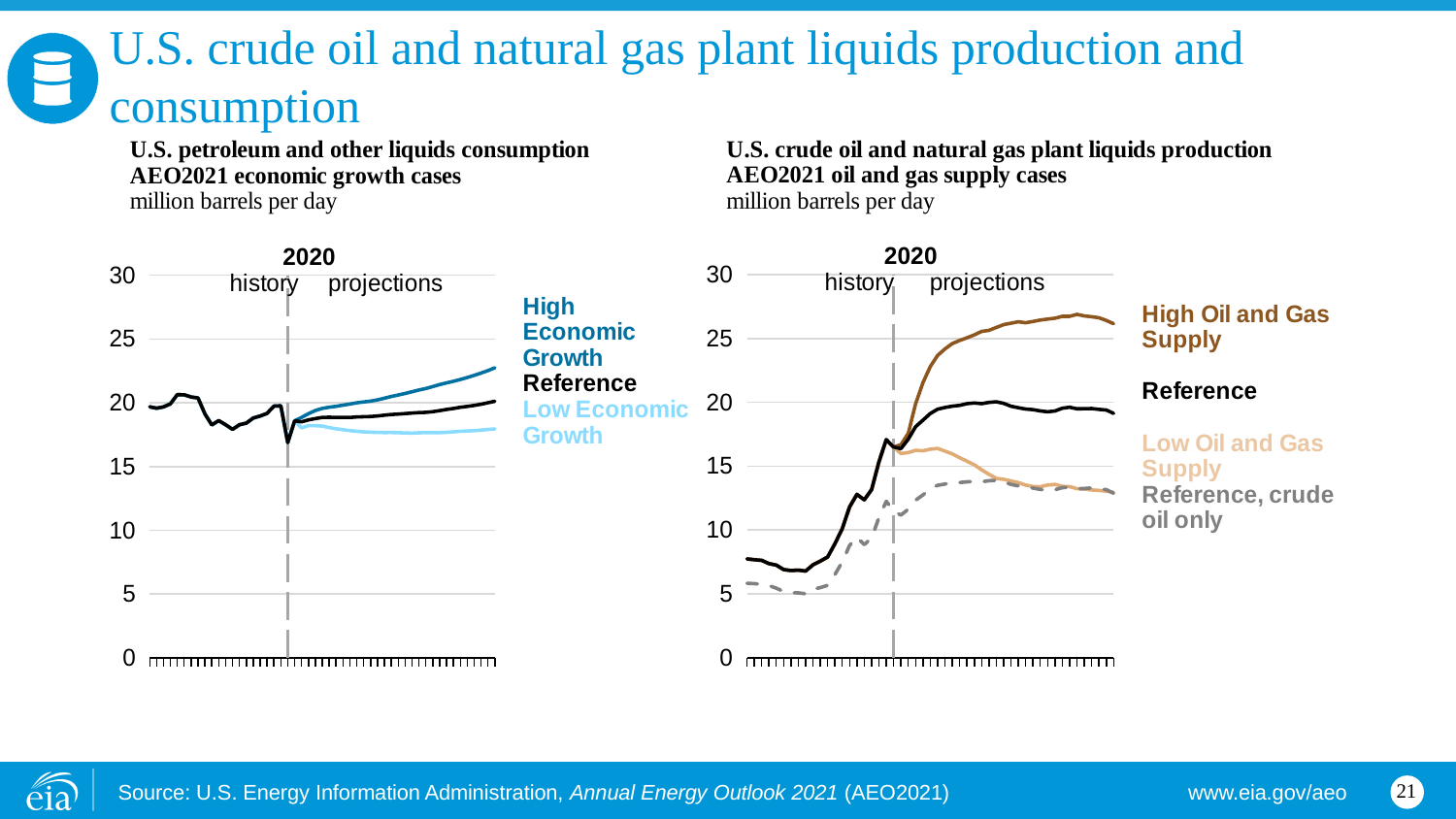
On the left chart, does the High Economic Growth series rise or fall over the projection period? rise How many series are labelled on the right chart, U.S. crude oil and natural gas plant liquids production? 4 On the right chart, which series is highest at the end of the projection period? High Oil and Gas Supply On the right chart, does the Low Oil and Gas Supply series rise or fall over the projection period? fall What unit is used on the y axis of both charts? million barrels per day On the left chart, is the value for Low Economic Growth at the end of the projection period greater or less than 20? less On the right chart, at the end of the projection period, which is larger: High Oil and Gas Supply or Reference? High Oil and Gas Supply On the right chart, is the value for High Oil and Gas Supply at the end of the projection period greater or less than 25? greater On the left chart, is the value for High Economic Growth at the end of the projection period greater or less than 20? greater How many series are labelled on the left chart, U.S. petroleum and other liquids consumption? 3 What kind of chart is the left chart, U.S. petroleum and other liquids consumption? line chart